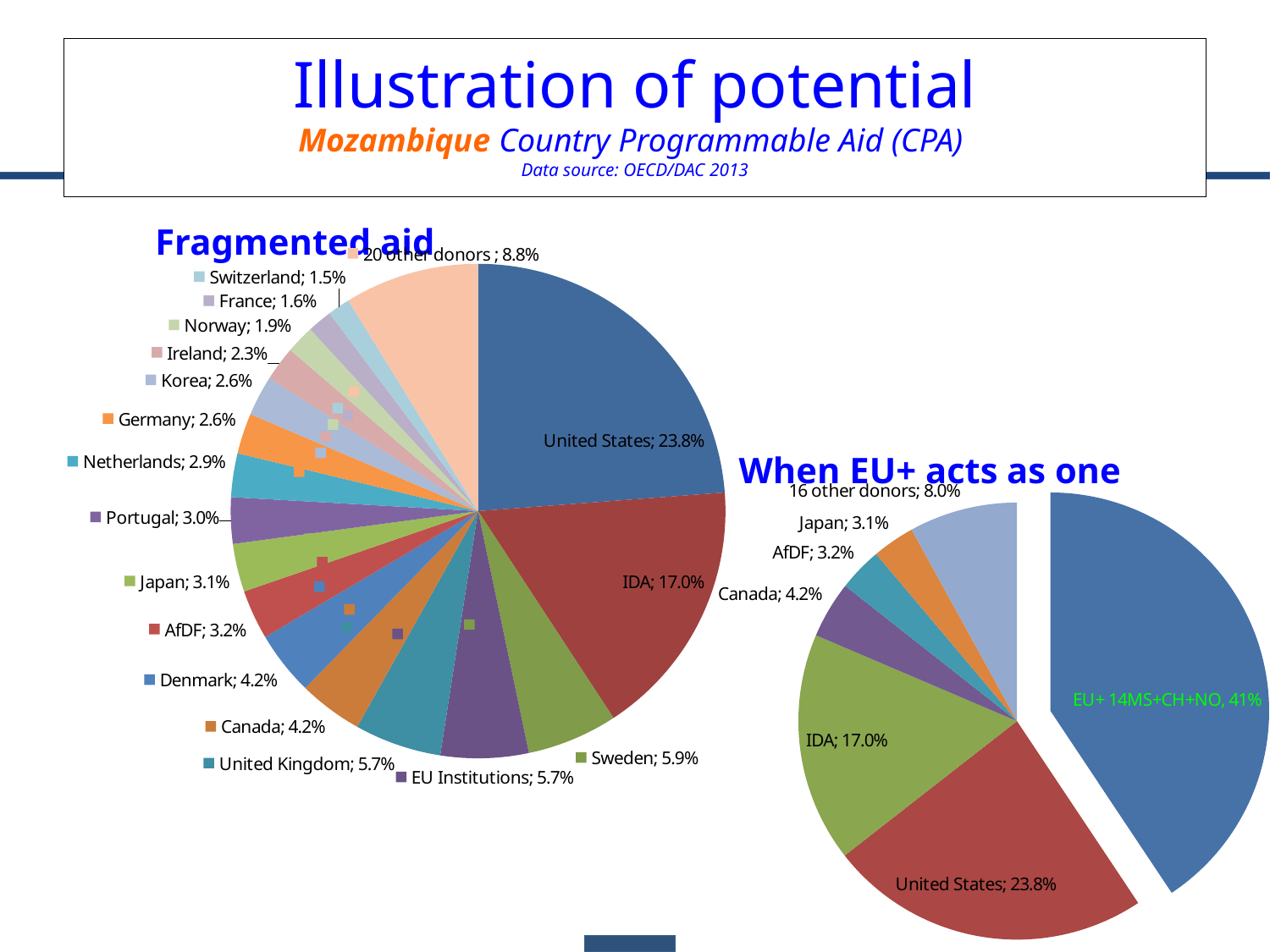
In the 'Fragmented aid' chart, which named donor has the smallest share? Switzerland In the 'When EU+ acts as one' chart, what share do the 16 other donors have? 8.0% How many slices does the 'When EU+ acts as one' pie chart have? 7 In the 'When EU+ acts as one' chart, which slice is the largest? EU+ 14MS+CH+NO In the 'Fragmented aid' chart, which donor has the largest share? United States In the 'Fragmented aid' chart, which is larger, the share for Portugal or the share for Netherlands? Portugal What type of chart is used for 'When EU+ acts as one'? Pie chart In the 'Fragmented aid' chart, what share does the United States have? 23.8% How many slices does the 'Fragmented aid' pie chart have? 18 In the 'Fragmented aid' chart, what share does Sweden have? 5.9% In the 'Fragmented aid' chart, what is the difference between the United States share and the IDA share? 6.8% In the 'When EU+ acts as one' chart, what share does EU+ 14MS+CH+NO have? 41%